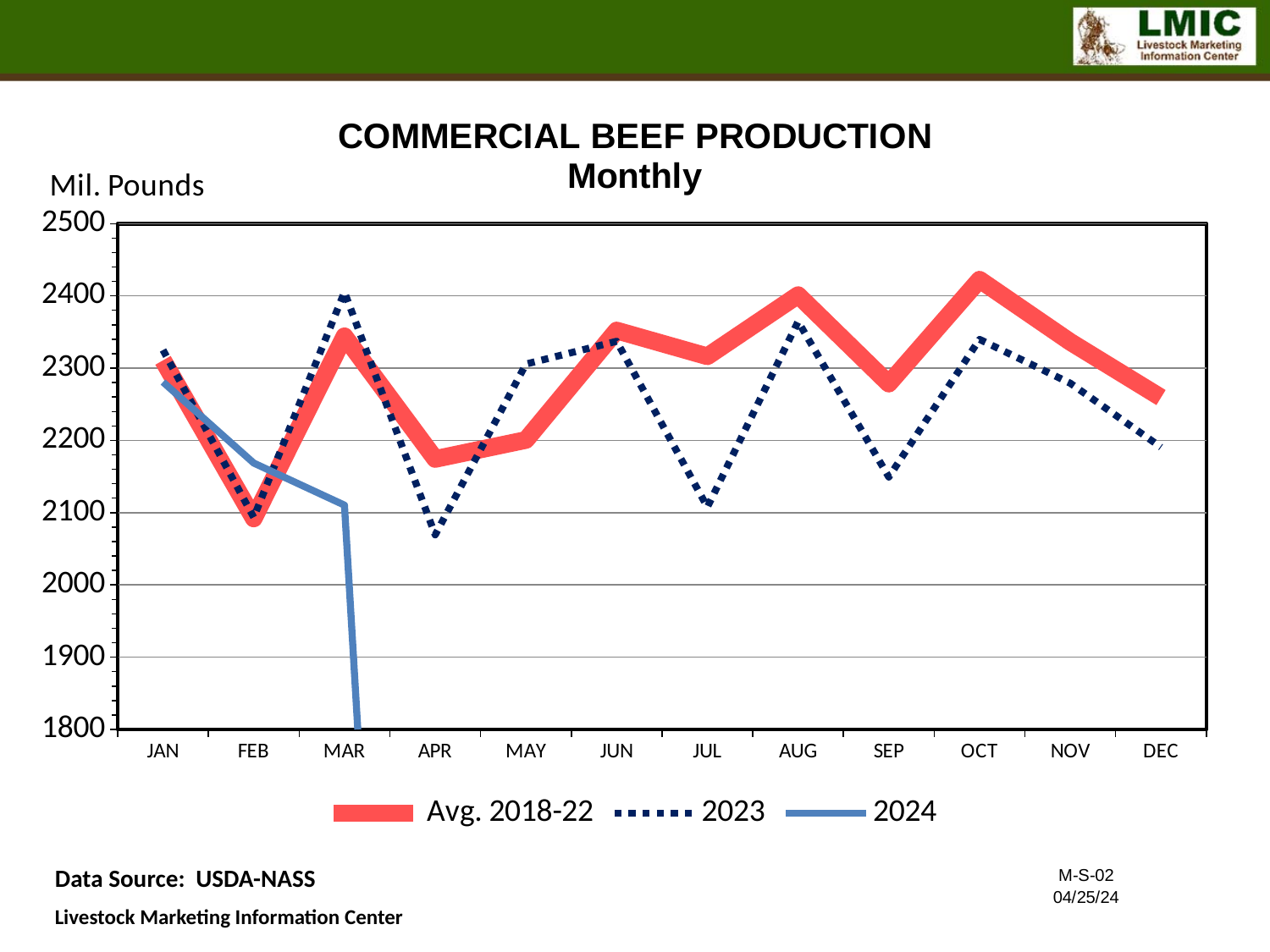
What is the title of the chart? COMMERCIAL BEEF PRODUCTION Monthly In which month is the Avg. 2018-22 series lowest? FEB What unit is shown on the y axis label? Mil. Pounds Is the 2024 value for FEB greater or less than 2200? less What kind of chart is shown on the slide? line chart Does the 2024 series rise or fall from JAN to FEB? fall How many series does the legend list? 3 In which month is the 2023 series highest? MAR Is the Avg. 2018-22 value for OCT greater or less than 2400? greater Is the 2023 value for APR greater or less than 2100? less How many months are shown along the x axis? 12 In AUG, which is larger: the Avg. 2018-22 value or the 2023 value? Avg. 2018-22